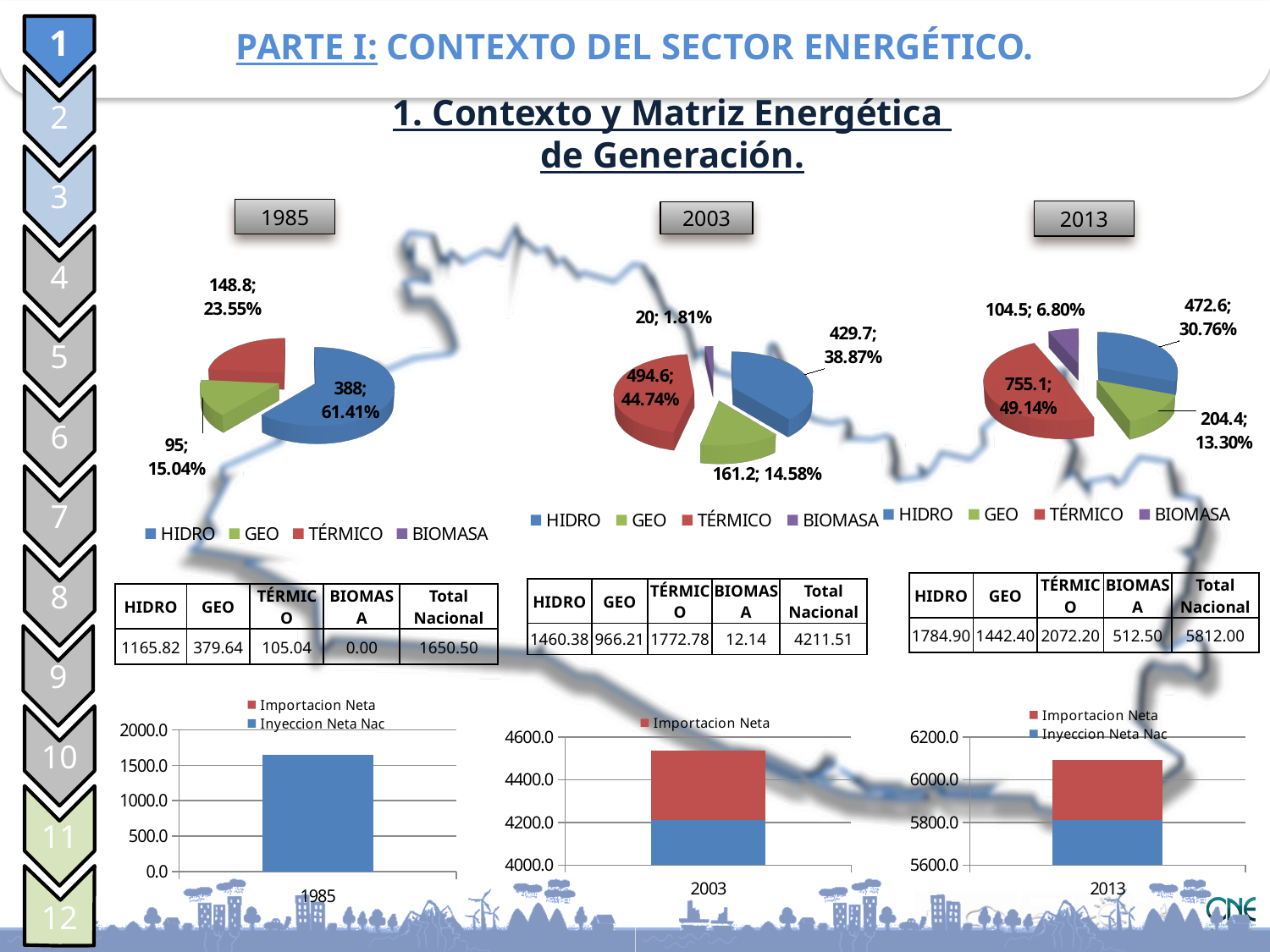
How many series does the legend of the 2003 pie chart list? 4 In the 2013 pie chart, what share of the pie does HIDRO have? 30.76% In the 2003 pie chart, what value is shown for GEO? 161.2 In the 1985 pie chart, what share of the pie does TÉRMICO have? 23.55% In the 2003 pie chart, which category has the smallest slice? BIOMASA In the 1985 pie chart, what value is shown for HIDRO? 388 What kind of chart is shown at the bottom right for 2013? Stacked bar chart In the 2003 pie chart, which category has the largest slice? TÉRMICO In the 2013 pie chart, what value is shown for BIOMASA? 104.5 In the 2013 pie chart, which is larger, GEO or BIOMASA? GEO In the bar chart at the bottom left for 1985, is the value for Inyeccion Neta Nac greater or less than 1500.0? greater In the 2013 pie chart, what is the difference between the TÉRMICO value and the HIDRO value? 282.5